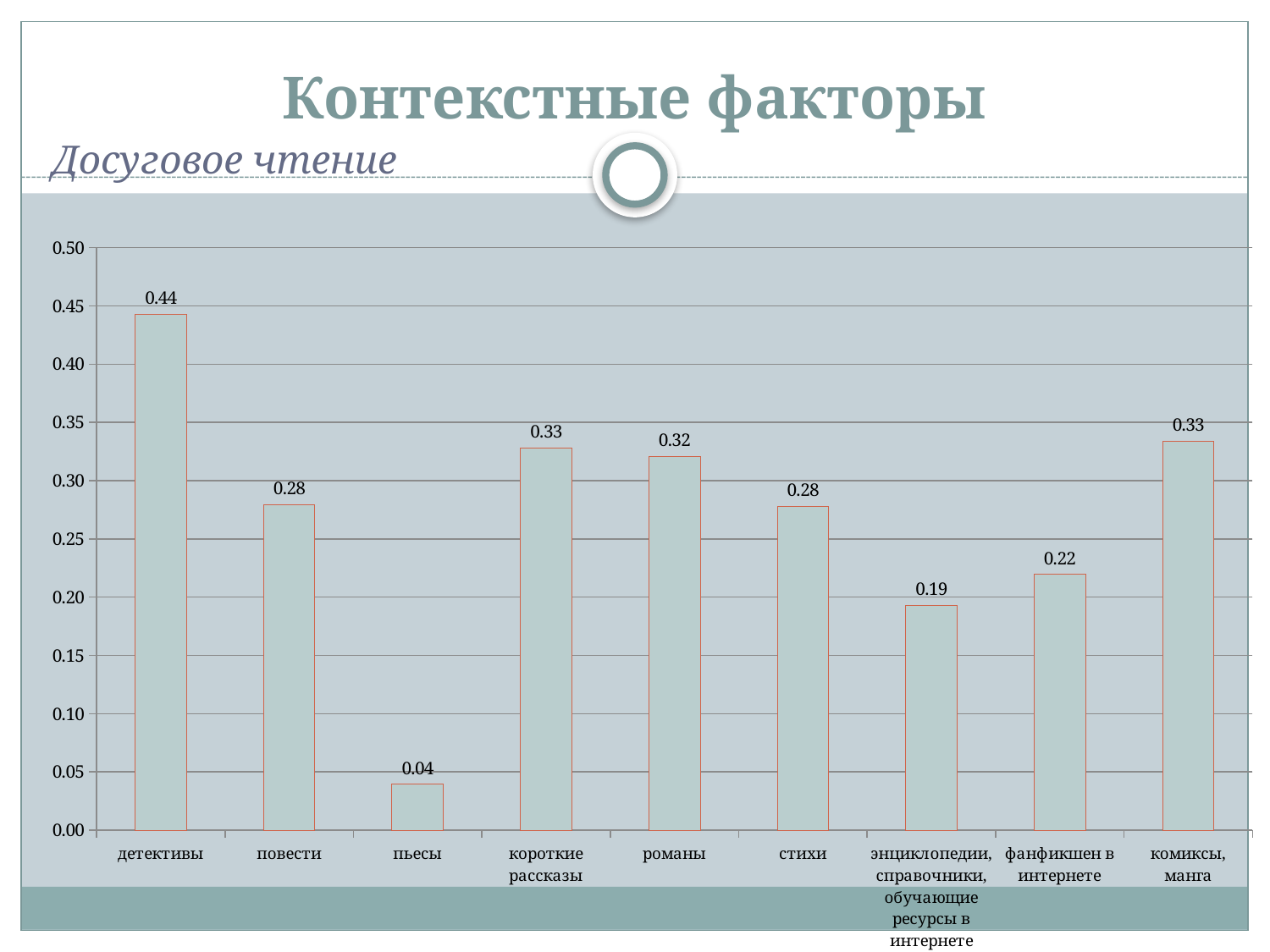
What is the value for фанфикшен в интернете? 0.22 Which is larger, the value for стихи or the value for фанфикшен в интернете? стихи Which category has the lowest value? пьесы What is the subtitle shown above the chart? Досуговое чтение How many categories are shown on the chart? 9 What is the value for романы? 0.32 Which category has the highest value? детективы What kind of chart is shown on the slide? bar chart What is the difference between the values for комиксы, манга and энциклопедии, справочники, обучающие ресурсы в интернете? 0.14 What is the value for детективы? 0.44 What is the value for пьесы? 0.04 What is the difference between the values for детективы and повести? 0.16